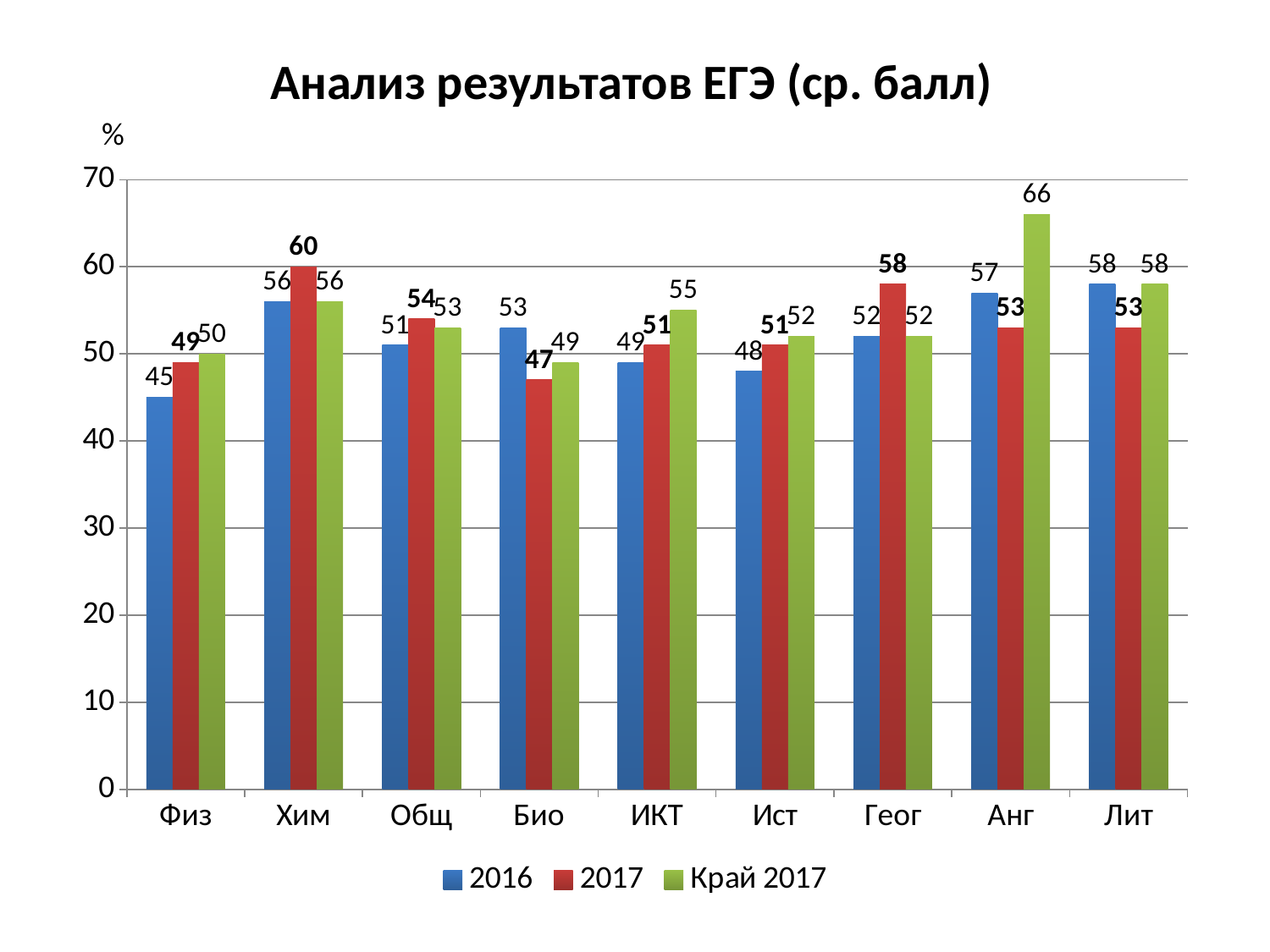
What is the 2017 value for Хим? 60 What is the 2016 value for Физ? 45 What is the Край 2017 value for Анг? 66 Which category has the lowest 2016 value? Физ Is the 2016 value for Ист greater or less than 50? less How many categories are shown on the x axis? 9 What is the title of the chart? Анализ результатов ЕГЭ (ср. балл) Which category has the highest 2017 value? Хим What is the difference between the Край 2017 value and the 2017 value for Анг? 13 Which is larger for Био: the 2016 value or the 2017 value? 2016 How many series does the legend list? 3 What kind of chart is shown on the slide? bar chart